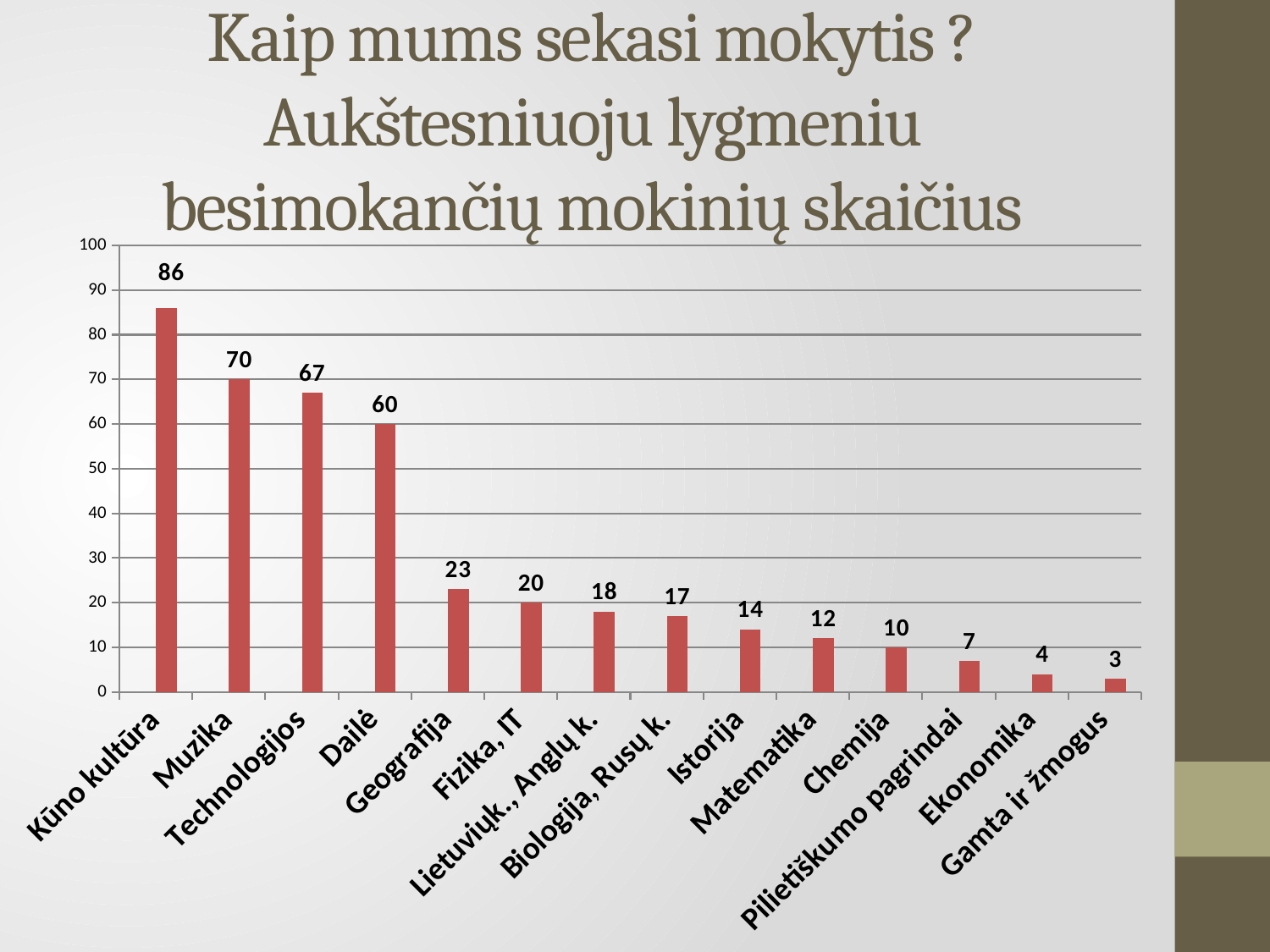
Which category has the lowest value? Gamta ir žmogus Which is larger, the value for Istorija or the value for Chemija? Istorija Is the value for Fizika, IT greater or less than 30? less What is the difference between the values for Muzika and Technologijos? 3 What is the value for Matematika? 12 What is the value for Kūno kultūra? 86 What is the value for Geografija? 23 Which category has the highest value? Kūno kultūra Do the values rise or fall from left to right along the x axis? fall How many categories are shown on the x axis? 14 What is the difference between the values for Dailė and Geografija? 37 What kind of chart is shown on the slide? bar chart